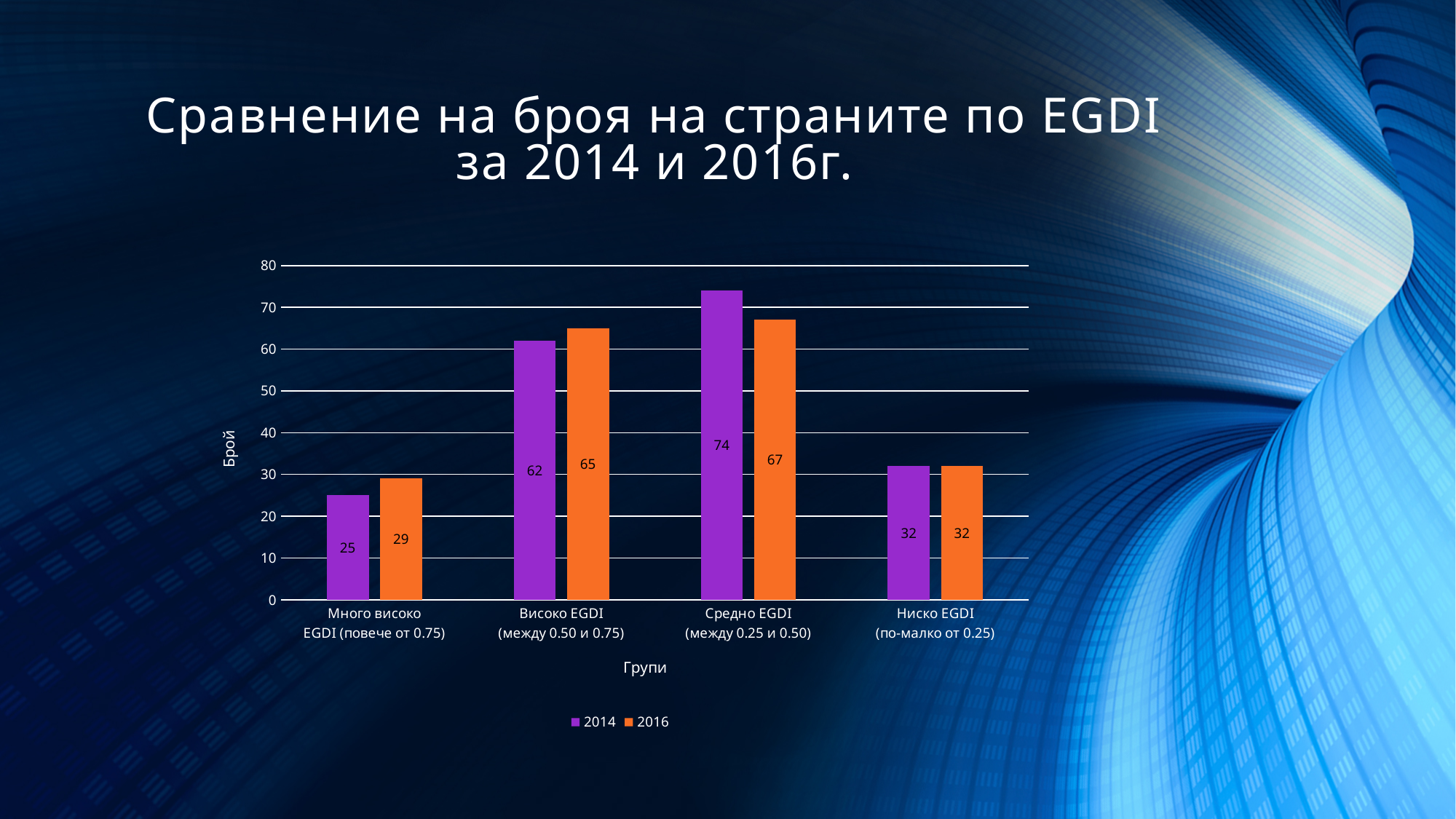
Which is larger for Високо EGDI (между 0.50 и 0.75): the 2014 value or the 2016 value? 2016 Which category has the lowest 2016 value? Много високо EGDI (повече от 0.75) Which category has the highest 2014 value? Средно EGDI (между 0.25 и 0.50) What is the 2016 value for Ниско EGDI (по-малко от 0.25)? 32 What is the label of the y axis? Брой What is the 2014 value for Много високо EGDI (повече от 0.75)? 25 Is the 2014 value for Средно EGDI (между 0.25 и 0.50) greater or less than 70? greater What kind of chart is shown on the slide? bar chart How many categories are shown on the x axis? 4 What is the difference between the 2014 and 2016 values for Средно EGDI (между 0.25 и 0.50)? 7 What is the 2016 value for Високо EGDI (между 0.50 и 0.75)? 65 How many series does the legend list? 2